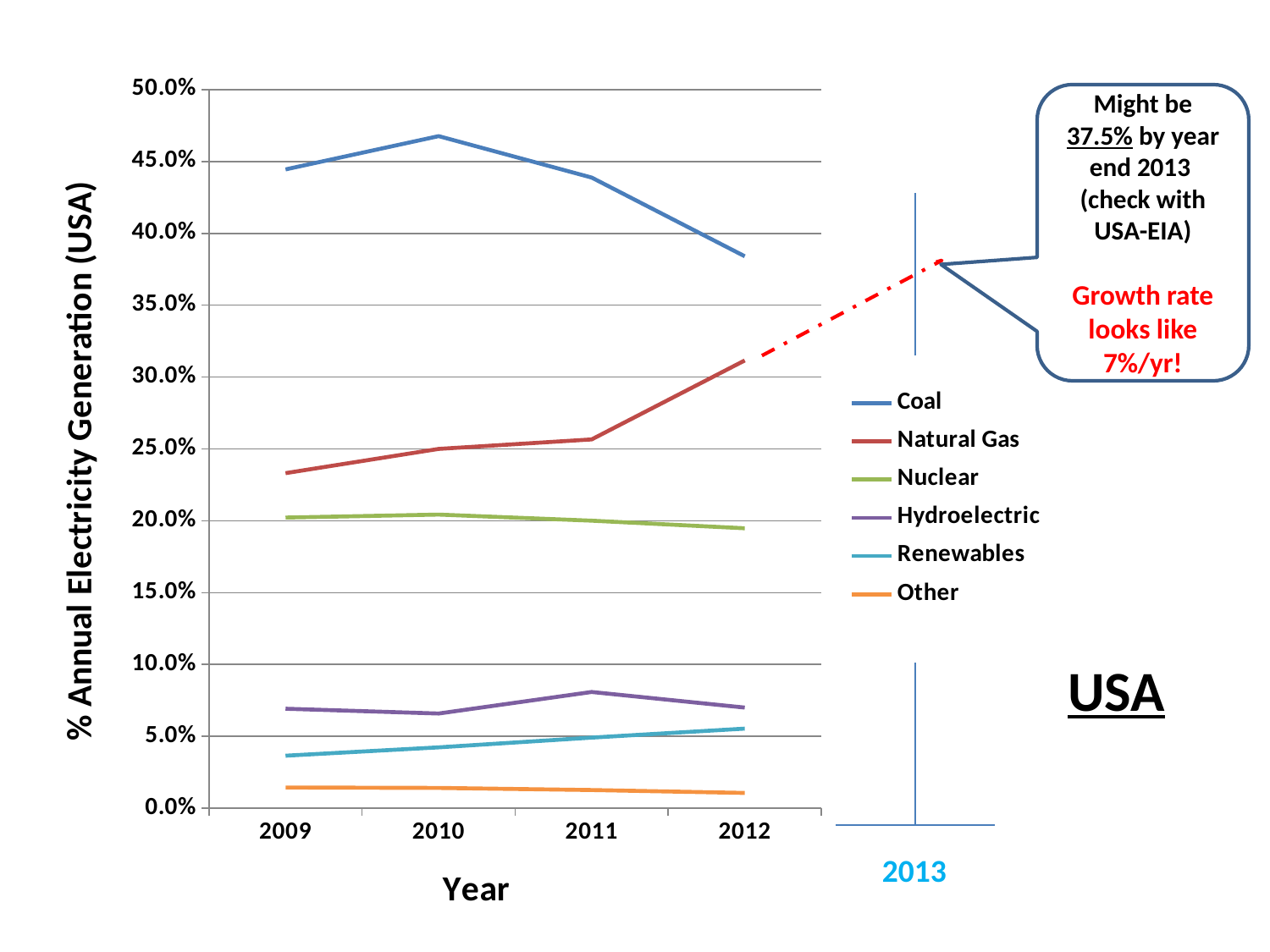
Is the value for Natural Gas in 2012 greater or less than 30.0%? greater What kind of chart is shown on the slide? line chart Is the value for Hydroelectric in 2011 greater or less than 10.0%? less How many years are plotted on the x axis of the chart? 4 Which series has the highest value in 2012? Coal Is the value for Coal in 2010 greater or less than 45.0%? greater Does the Natural Gas line rise or fall from 2009 to 2012? rise How many series does the legend list? 6 Which is larger in 2012, Nuclear or Hydroelectric? Nuclear Which series has the lowest value in 2012? Other What is the title of the y axis? % Annual Electricity Generation (USA)